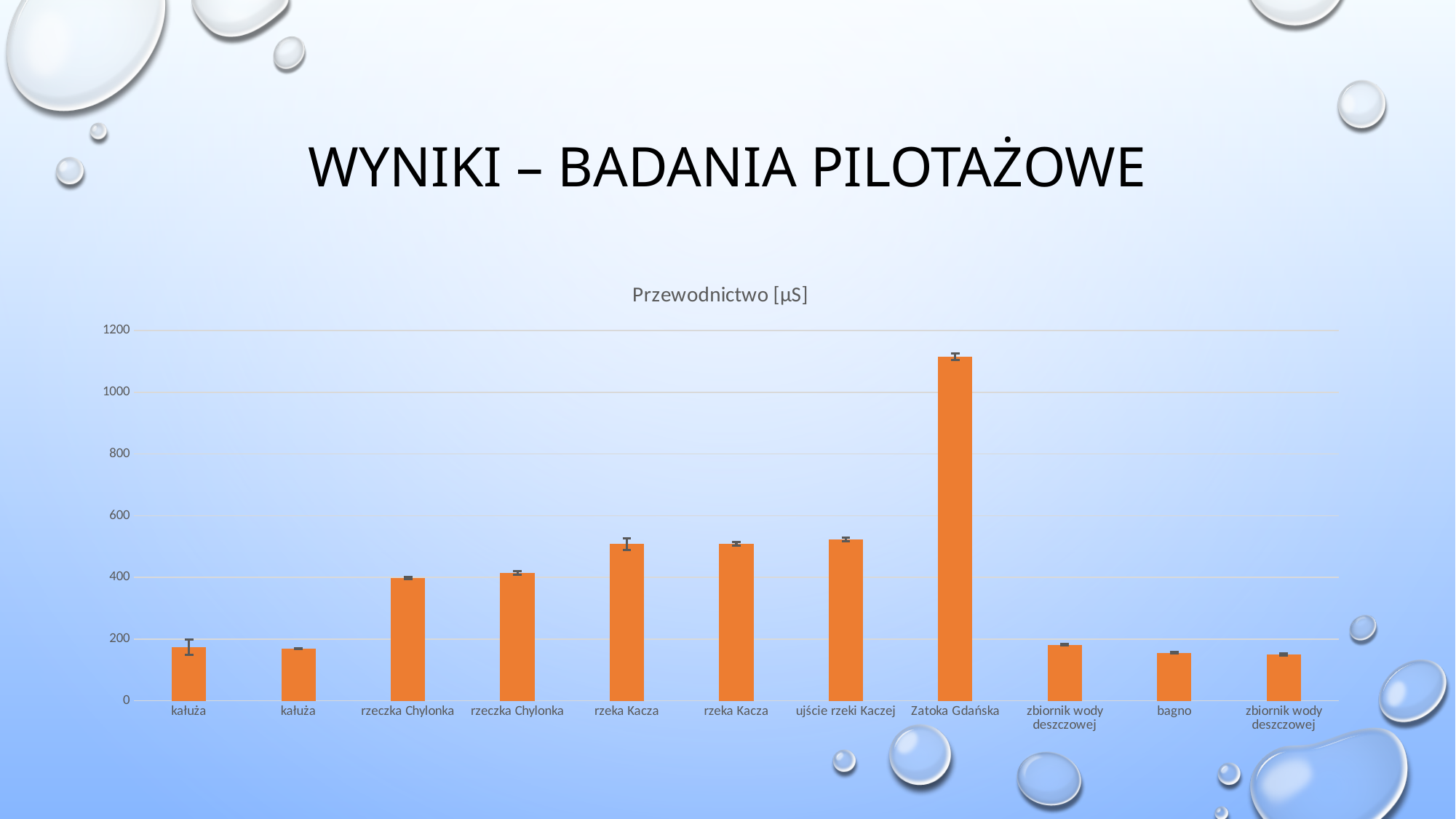
How many bars are plotted in the chart? 11 What is the highest tick value shown on the vertical axis? 1200 Are the values for the first rzeka Kacza bar greater or less than 600? less What kind of chart is shown on the slide? bar chart Which is larger, the value for bagno or the value for ujście rzeki Kaczej? ujście rzeki Kaczej Which is larger, the value for Zatoka Gdańska or the value for ujście rzeki Kaczej? Zatoka Gdańska What is the title of the chart? Przewodnictwo [μS] Is the value for bagno greater or less than 200? less Is the value for ujście rzeki Kaczej greater or less than 400? greater Which category has the highest value? Zatoka Gdańska